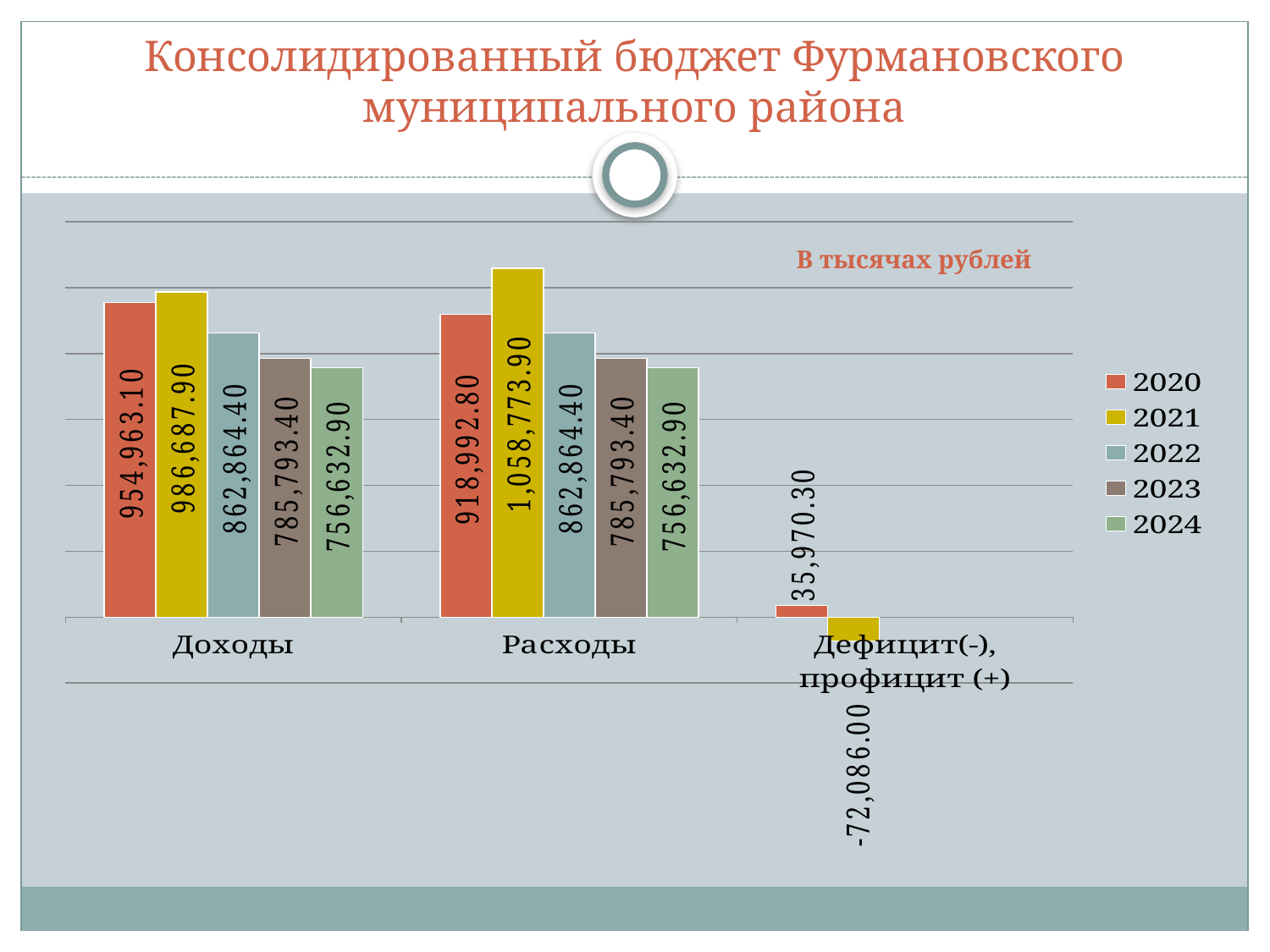
Which year has the lowest value for Доходы? 2024 What type of chart is shown on the slide? Bar chart How many categories are shown on the x axis? 3 What unit is stated on the chart for the values? В тысячах рублей What is the value of Доходы for 2021? 986,687.90 How many series does the legend list? 5 What is the value of Дефицит(-), профицит (+) for 2021? -72,086.00 Which is larger for 2020: Доходы or Расходы? Доходы What is the value of Доходы for 2024? 756,632.90 Which year has the highest value for Расходы? 2021 What is the value of Расходы for 2020? 918,992.80 What is the difference between Расходы and Доходы for 2021? 72,086.00